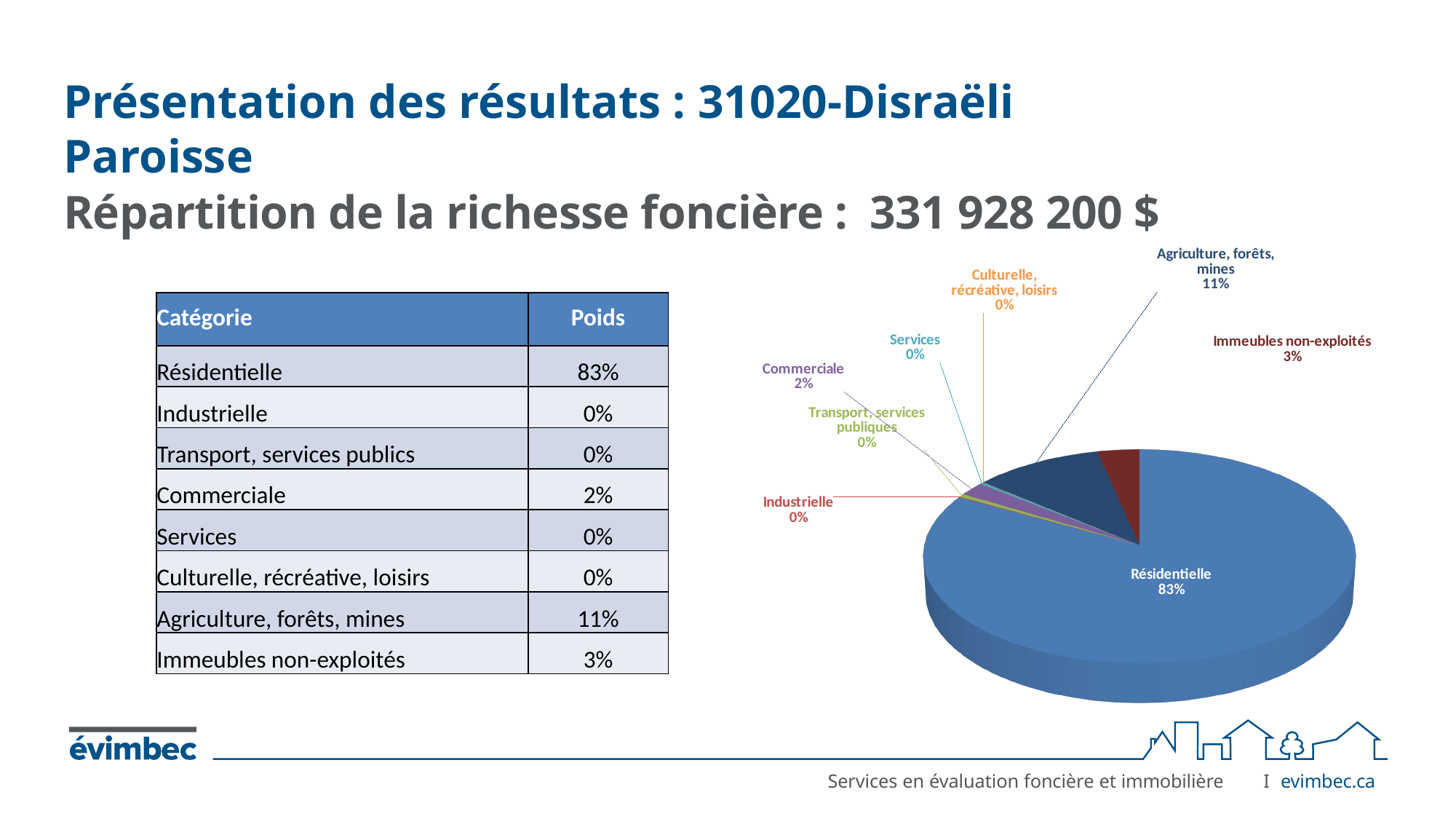
What kind of chart is shown on the slide? Pie chart What is the value shown for Commerciale in the pie chart? 2% Which category has the largest slice of the pie chart? Résidentielle What total amount is stated in the slide heading above the chart? 331 928 200 $ How many categories are labelled in the pie chart? 8 How many categories in the pie chart are labelled 0%? 4 Which is larger in the pie chart, Agriculture, forêts, mines or Immeubles non-exploités? Agriculture, forêts, mines What share of the pie does Résidentielle represent? 83% What is the value shown for Agriculture, forêts, mines in the pie chart? 11% What is the difference between the Résidentielle share and the Agriculture, forêts, mines share? 72% What is the value shown for Industrielle in the pie chart? 0% What is the value shown for Immeubles non-exploités in the pie chart? 3%